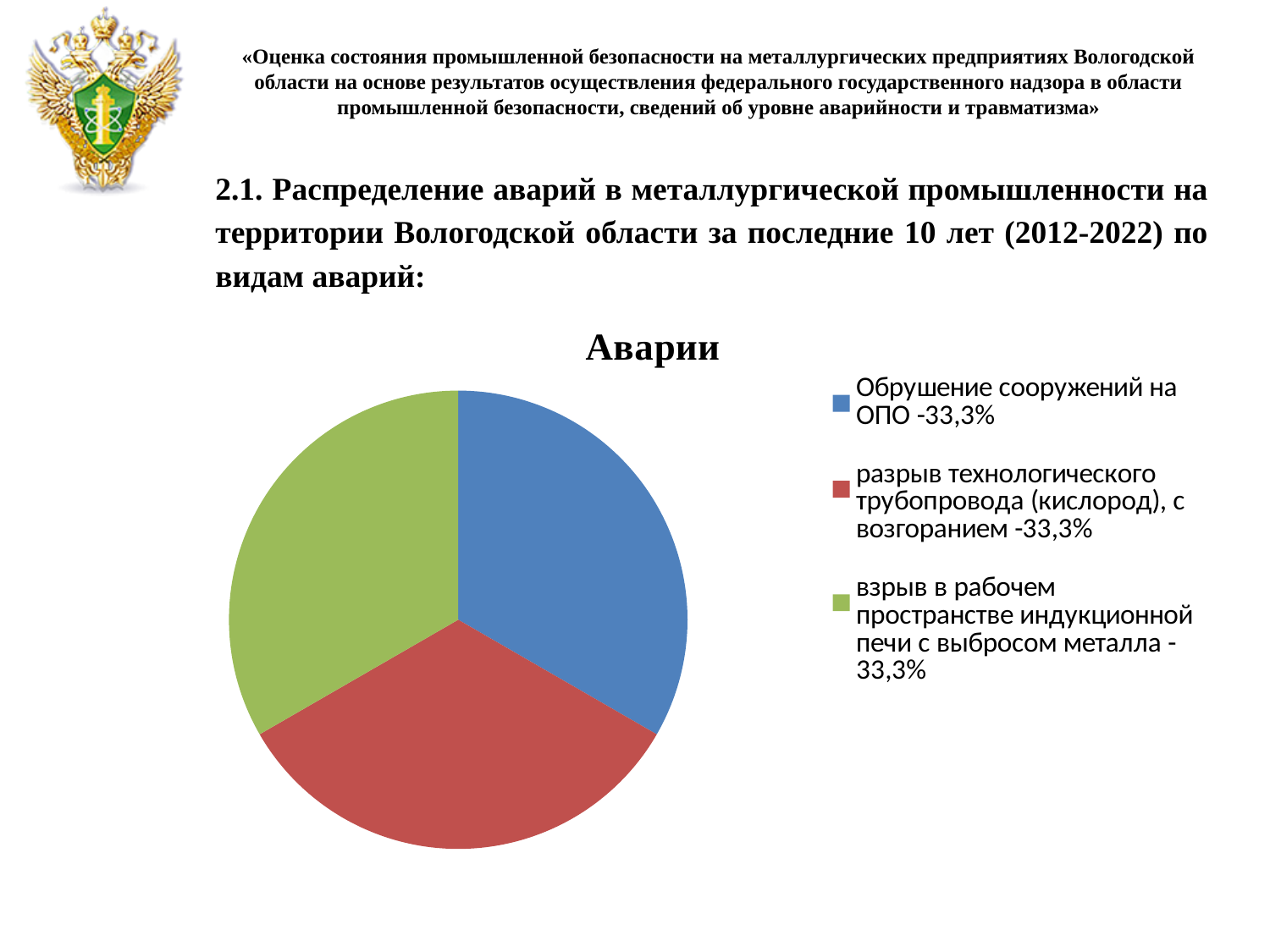
What colour is the slice for "Обрушение сооружений на ОПО"? blue What is the title of the chart? Аварии How many entries does the legend list? 3 What is the difference between the share for "Обрушение сооружений на ОПО" and the share for "разрыв технологического трубопровода (кислород), с возгоранием"? 0% What share of the pie does "разрыв технологического трубопровода (кислород), с возгоранием" represent? 33,3% What share of the pie does "взрыв в рабочем пространстве индукционной печи с выбросом металла" represent? 33,3% How many slices does the pie chart have? 3 What share of the pie does "Обрушение сооружений на ОПО" represent? 33,3% Is the share for "Обрушение сооружений на ОПО" greater or less than 50%? less What kind of chart is shown on the slide? pie chart Is the share for "взрыв в рабочем пространстве индукционной печи с выбросом металла" greater or less than 25%? greater